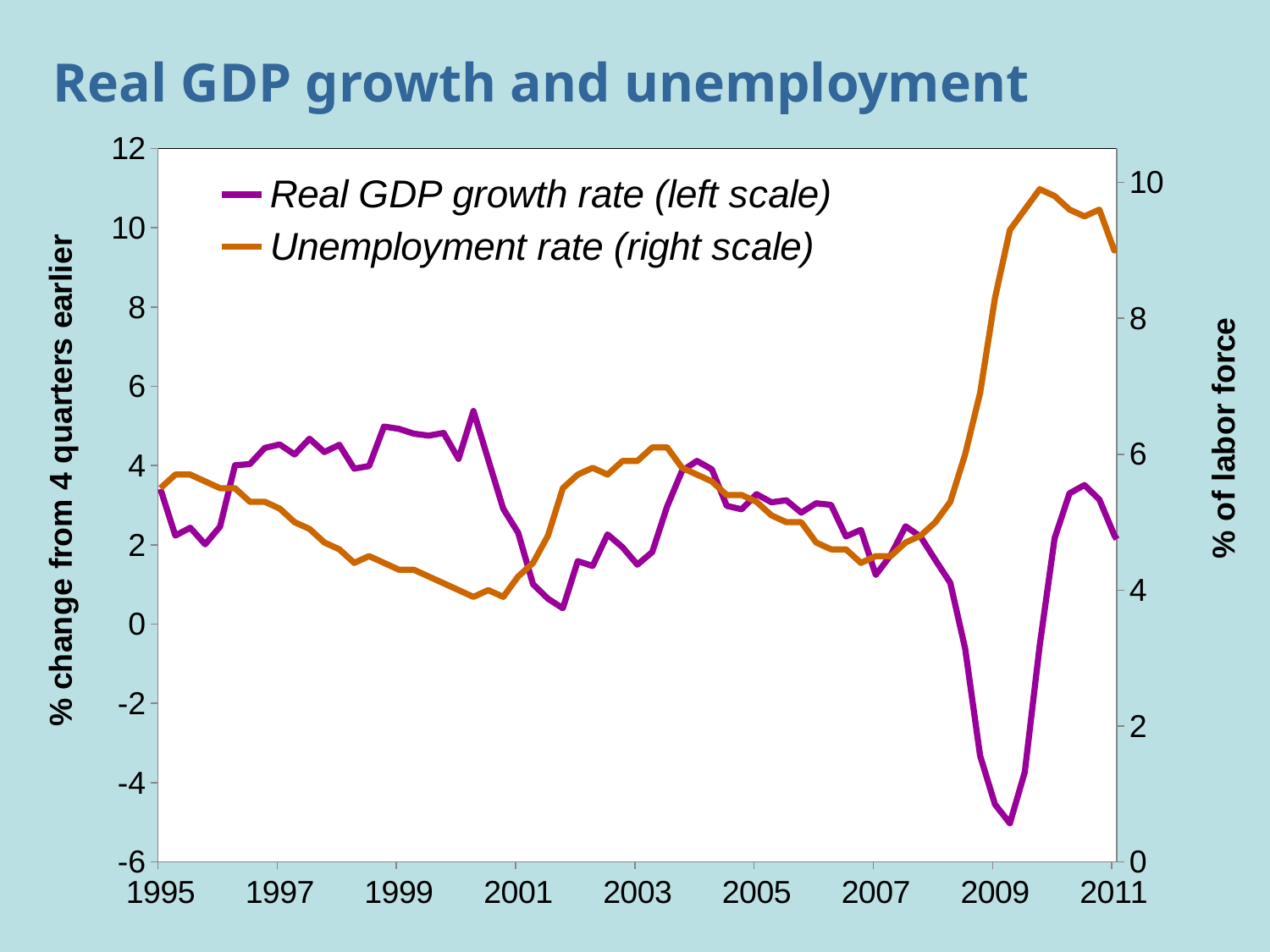
What kind of chart is shown on the slide? line chart What is the title of the chart? Real GDP growth and unemployment Which series is plotted in purple? Real GDP growth rate (left scale) Does the real GDP growth rate rise or fall between 2009 and 2010? rise Does the unemployment rate rise or fall between 2008 and 2009? rise Is the peak value of the unemployment rate (right scale) greater or less than 8? greater How many series does the legend list? 2 Is the lowest value of the real GDP growth rate (left scale) greater or less than -4? less Is the real GDP growth rate (left scale) at 2011 greater or less than 0? greater Does the unemployment rate rise or fall between 1995 and 2000? fall